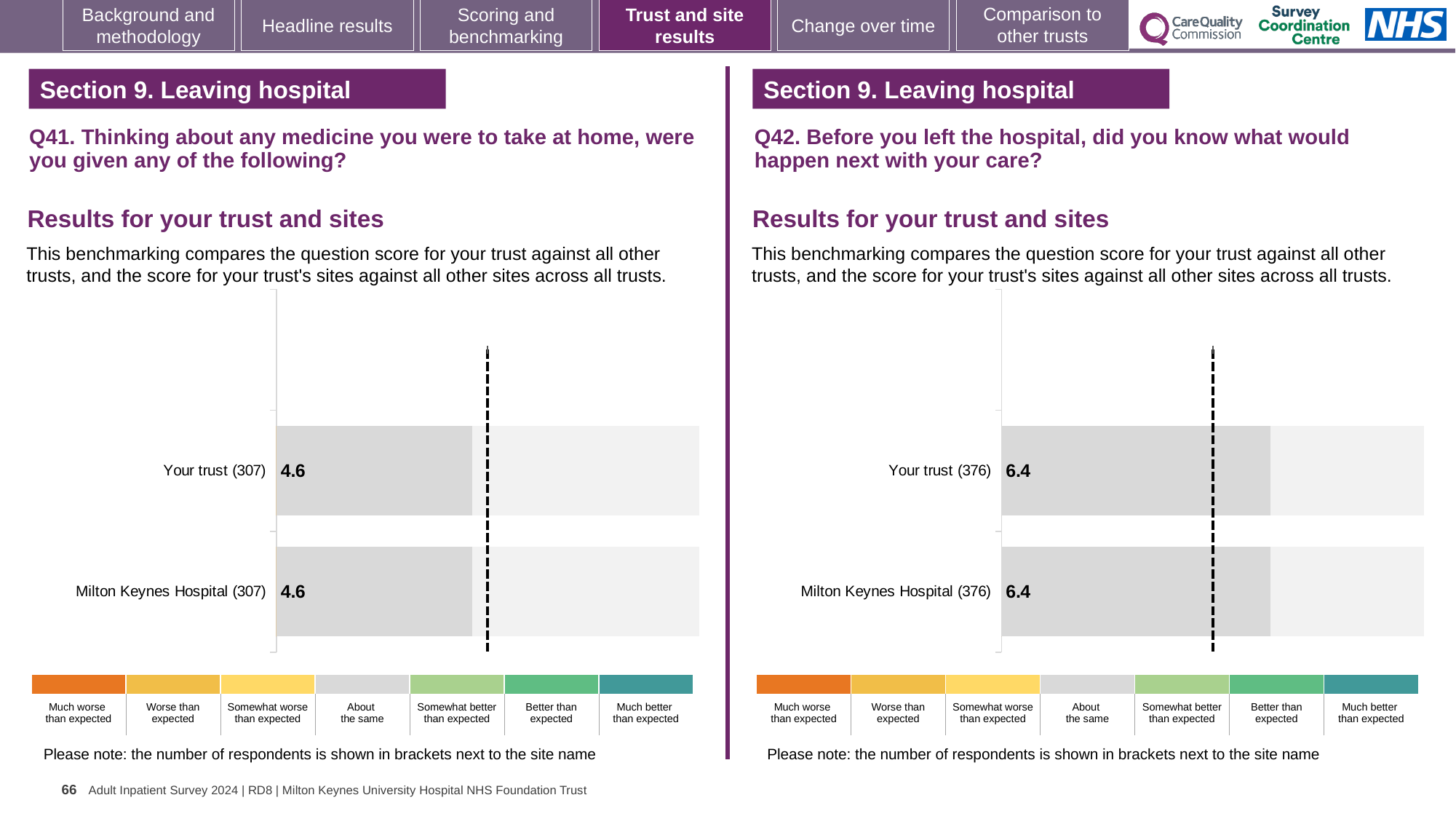
Is the score for Your trust on the right chart (Q42) larger than the score for Your trust on the left chart (Q41)? Yes On the right chart (Q42), what is the score for Milton Keynes Hospital? 6.4 On the left chart (Q41), what is the difference between the score for Your trust and the score for Milton Keynes Hospital? 0 On the right chart (Q42), what is the score for Your trust? 6.4 What is the label of the middle category in the colour key below the right chart (Q42)? About the same On the left chart (Q41), what is the score for Milton Keynes Hospital? 4.6 What kind of chart is used on the left (Q41) to show the results for your trust and sites? Bar chart On the left chart (Q41), how many respondents are shown in brackets next to Your trust? 307 On the right chart (Q42), how many respondents are shown in brackets next to Milton Keynes Hospital? 376 On the left chart (Q41), what is the score for Your trust? 4.6 How many categories does the colour key below the left chart (Q41) list? 7 On the right chart (Q42), how many bars are plotted? 2